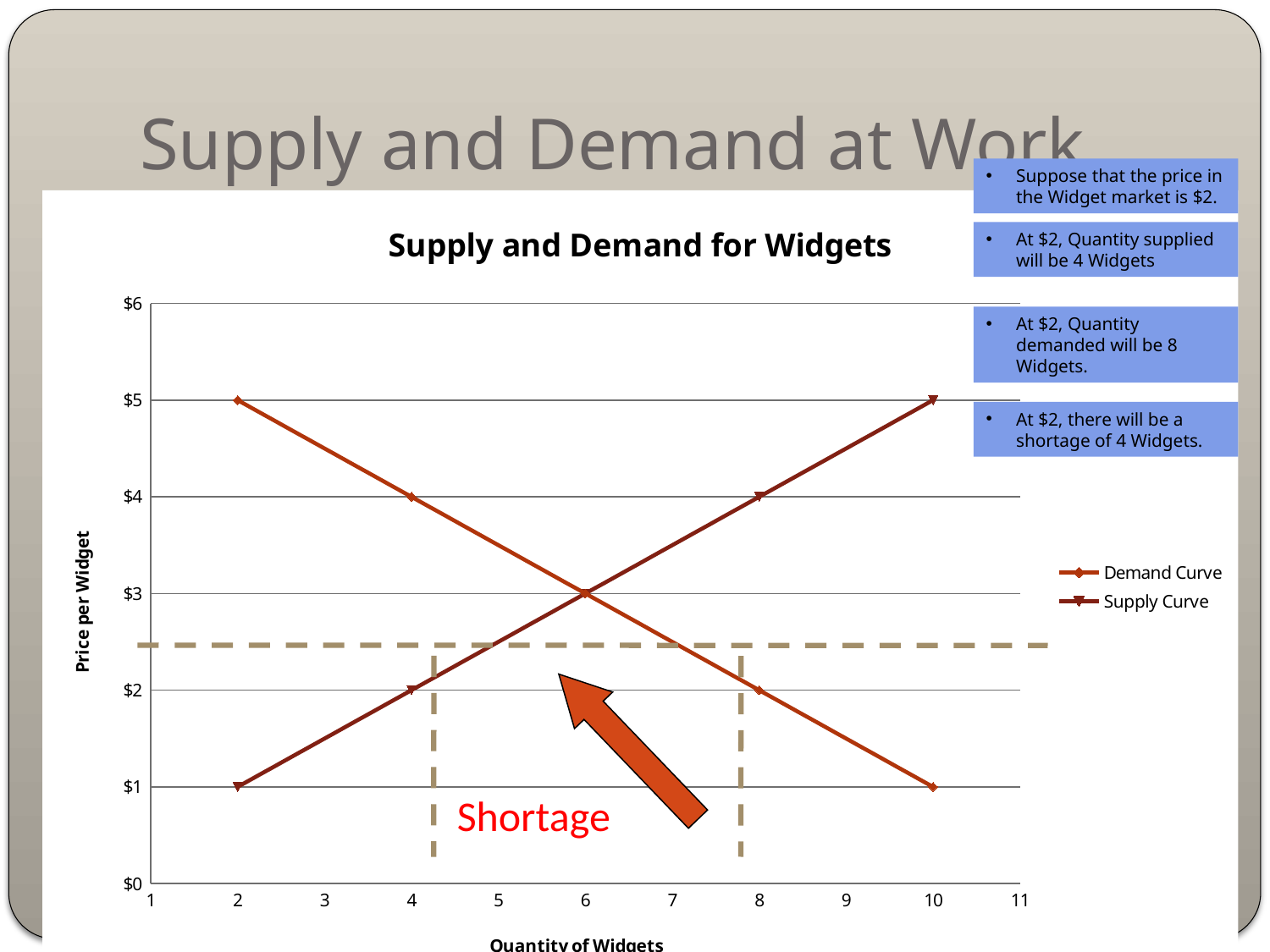
What is the price on the Supply Curve at a quantity of 4 widgets? $2 What are the two series named in the legend? Demand Curve and Supply Curve At a quantity of 2 widgets, which series has the higher price, the Demand Curve or the Supply Curve? Demand Curve What kind of chart is shown on the slide? line chart How many series does the chart legend list? 2 Does the Demand Curve rise or fall as quantity increases along the x axis? fall How many data points are plotted on the Demand Curve? 5 What is the title of the chart? Supply and Demand for Widgets What is the price on the Demand Curve at a quantity of 8 widgets? $2 Does the Supply Curve rise or fall as quantity increases along the x axis? rise At what quantity do the Demand Curve and Supply Curve intersect? 6 At what price do the Demand Curve and Supply Curve intersect? $3